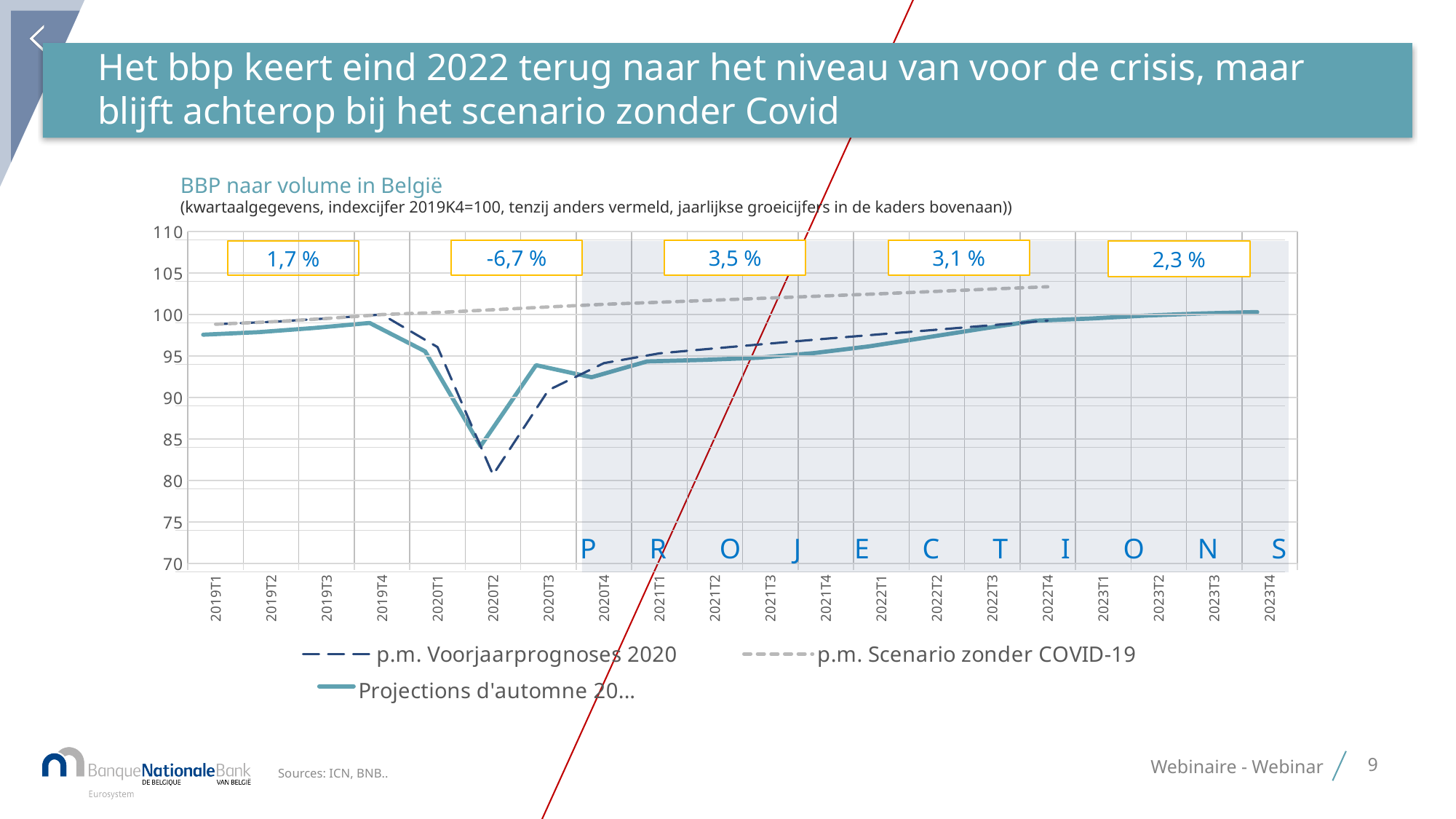
How many series does the chart legend list? 3 What kind of chart is shown on the slide? line chart In which quarter does the 'Projections d'automne' series reach its lowest value? 2020T2 Which of the annual growth rates printed in the boxes at the top of the chart is the highest? 3,5 % Which of the annual growth rates printed in the boxes at the top of the chart is the lowest? -6,7 % How many quarters are shown on the x axis of the chart? 20 At 2020T2, which series has the higher value: 'p.m. Voorjaarprognoses 2020' or 'Projections d'automne'? Projections d'automne What annual growth rate is printed in the box above the 2021 quarters? 3,5 % What annual growth rate is printed in the box above the 2020 quarters? -6,7 % Is the value of the 'p.m. Scenario zonder COVID-19' series at 2022T4 greater or less than 100? greater Does the 'p.m. Scenario zonder COVID-19' series rise or fall along the x axis? rise Is the value of the 'p.m. Voorjaarprognoses 2020' series at 2020T2 greater or less than 85? less